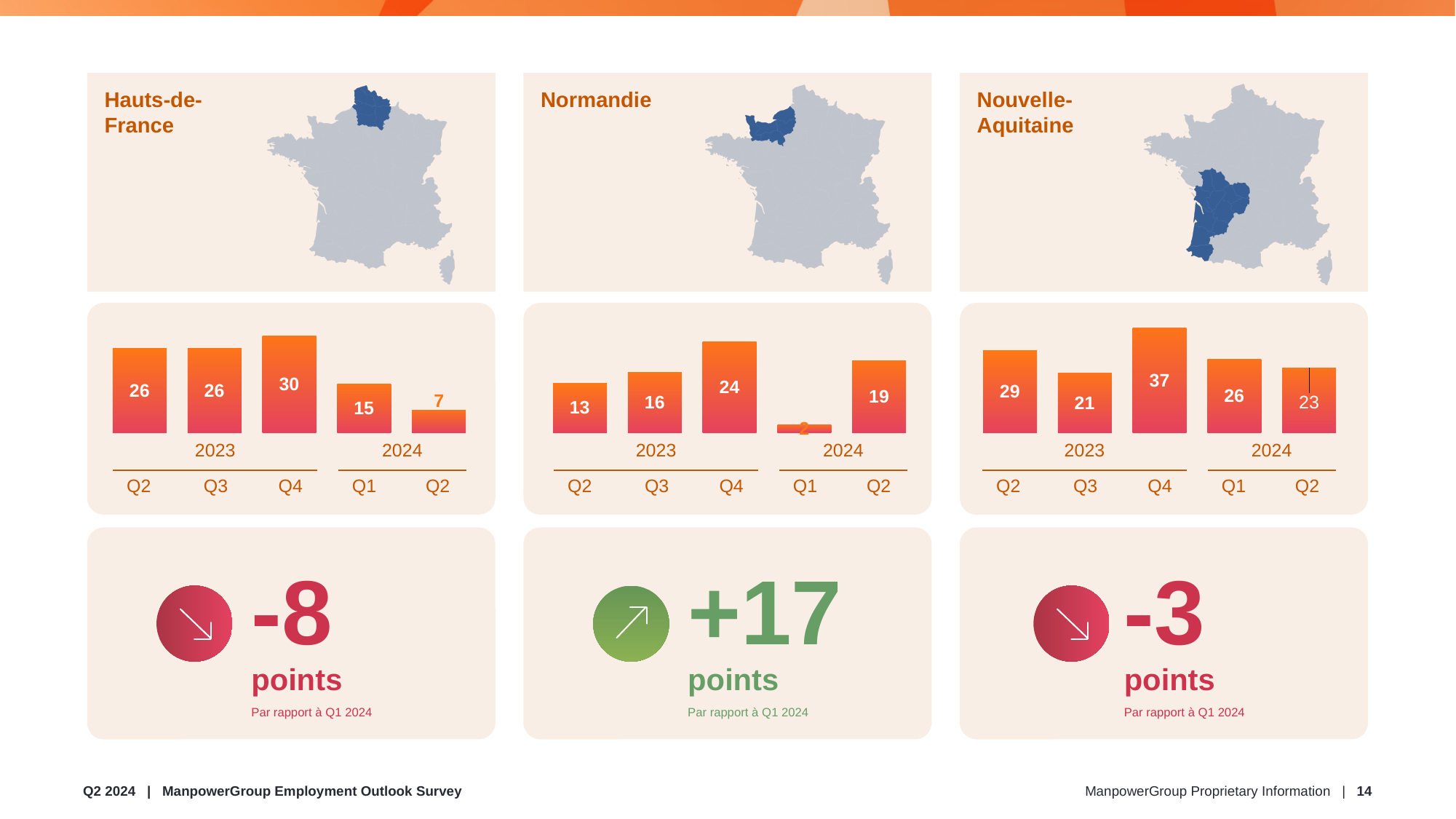
In the Nouvelle-Aquitaine chart, which quarter has the highest value? Q4 2023 How many bars are plotted in the Normandie chart? 5 In the Normandie chart, do the values rise or fall from Q2 2023 to Q4 2023? Rise In the Normandie chart, what is the value for Q2 2024? 19 In the Hauts-de-France chart, which quarter has the lowest value? Q2 2024 In the Nouvelle-Aquitaine chart, which is larger, the value for Q2 2023 or the value for Q1 2024? Q2 2023 In the Normandie chart, what is the difference between the Q4 2023 value and the Q2 2024 value? 5 In the Hauts-de-France chart, what is the value for Q4 2023? 30 In the Hauts-de-France chart, what is the difference between the Q1 2024 value and the Q2 2024 value? 8 In the Hauts-de-France chart, what is the value for Q2 2024? 7 What kind of chart is used for the Hauts-de-France data? Bar chart In the Nouvelle-Aquitaine chart, what is the value for Q3 2023? 21